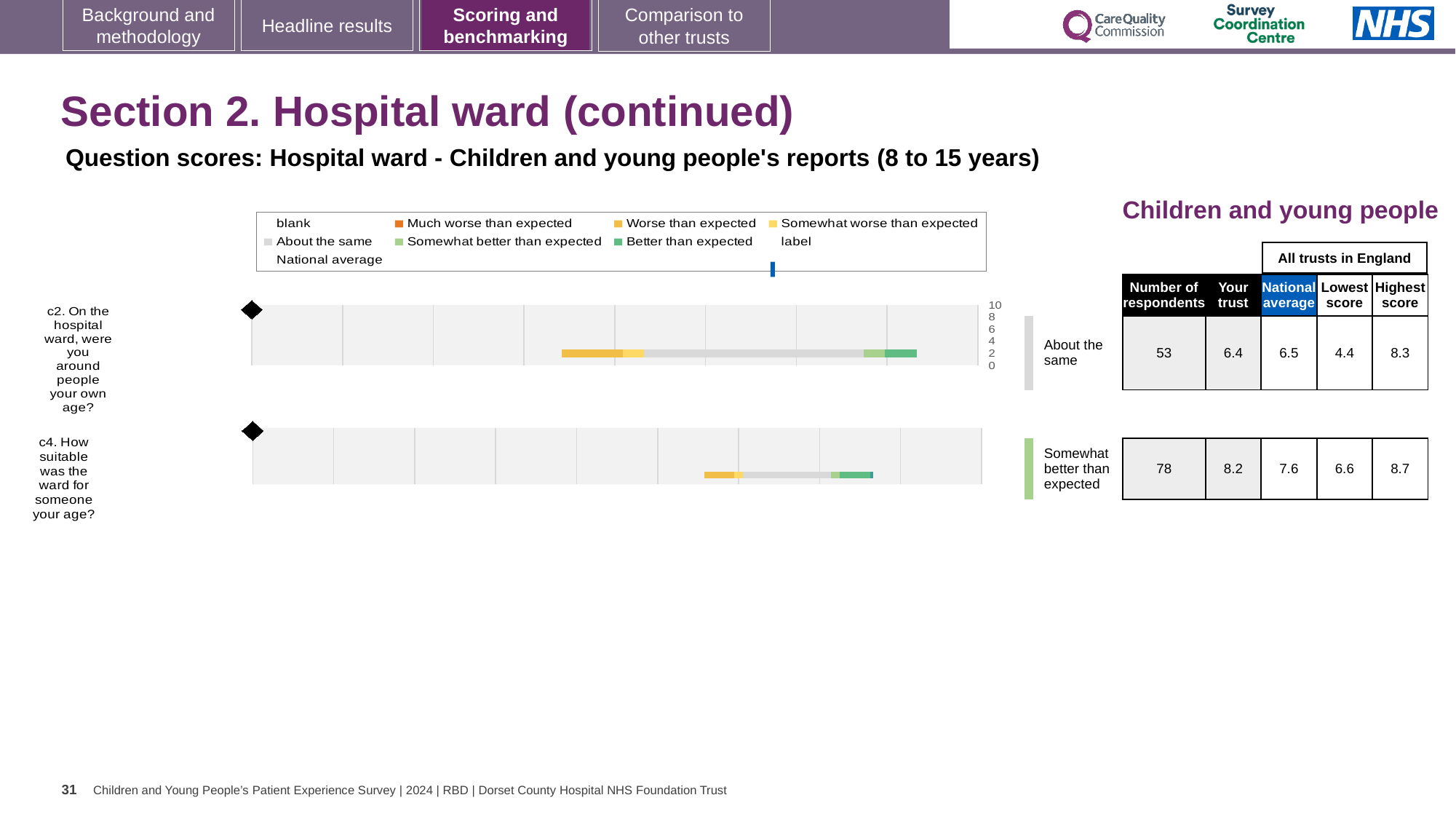
What kind of chart is used to show the question scores for c2 and c4? bar chart What is the national average score for c4 (How suitable was the ward for someone your age?)? 7.6 What benchmark category is shown for c4? Somewhat better than expected What is the 'Your trust' score for c2 (On the hospital ward, were you around people your own age?)? 6.4 How many questions are plotted on the slide? 2 What is the lowest score across all trusts in England for c2? 4.4 What is the difference between the national average and the trust's score for c2? 0.1 What is the highest score across all trusts in England for c2? 8.3 What benchmark category is shown for c2? About the same Which question has the higher 'Your trust' score, c2 or c4? c4 How many respondents answered c4? 78 What is the difference between the highest and lowest scores for c4? 2.1